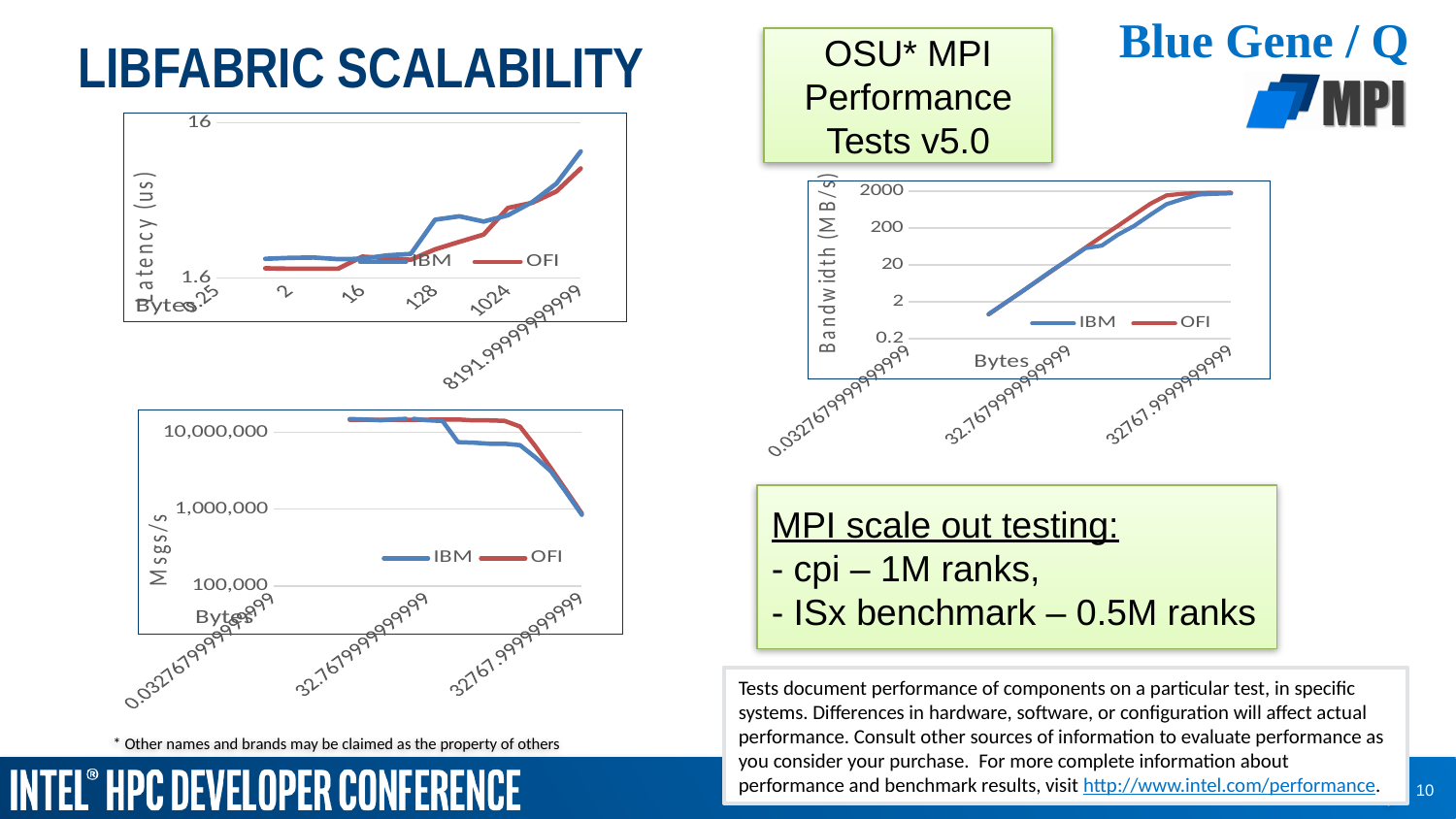
In the Bandwidth (MB/s) chart, is the OFI bandwidth at the largest byte size greater or less than 200? greater In the Latency (us) chart, is the IBM latency at the largest byte size greater or less than 1.6? greater How many series does the legend of the Bandwidth (MB/s) chart list? 2 What is the y-axis label of the chart on the right side of the slide? Bandwidth (MB/s) In the Msgs/s chart, is the IBM message rate at the smallest byte size greater or less than 10,000,000? greater In the Latency (us) chart, which series has the higher latency at the largest byte size, IBM or OFI? IBM In the Msgs/s chart, do the message rate values rise or fall as the number of bytes increases along the x axis? fall In the Latency (us) chart, do the latency values rise or fall as the number of bytes increases along the x axis? rise What type of chart is the Latency (us) chart on the left of the slide? line chart In the Bandwidth (MB/s) chart, do the bandwidth values rise or fall as the number of bytes increases along the x axis? rise Which two series are shown in the legend of the Msgs/s chart? IBM and OFI